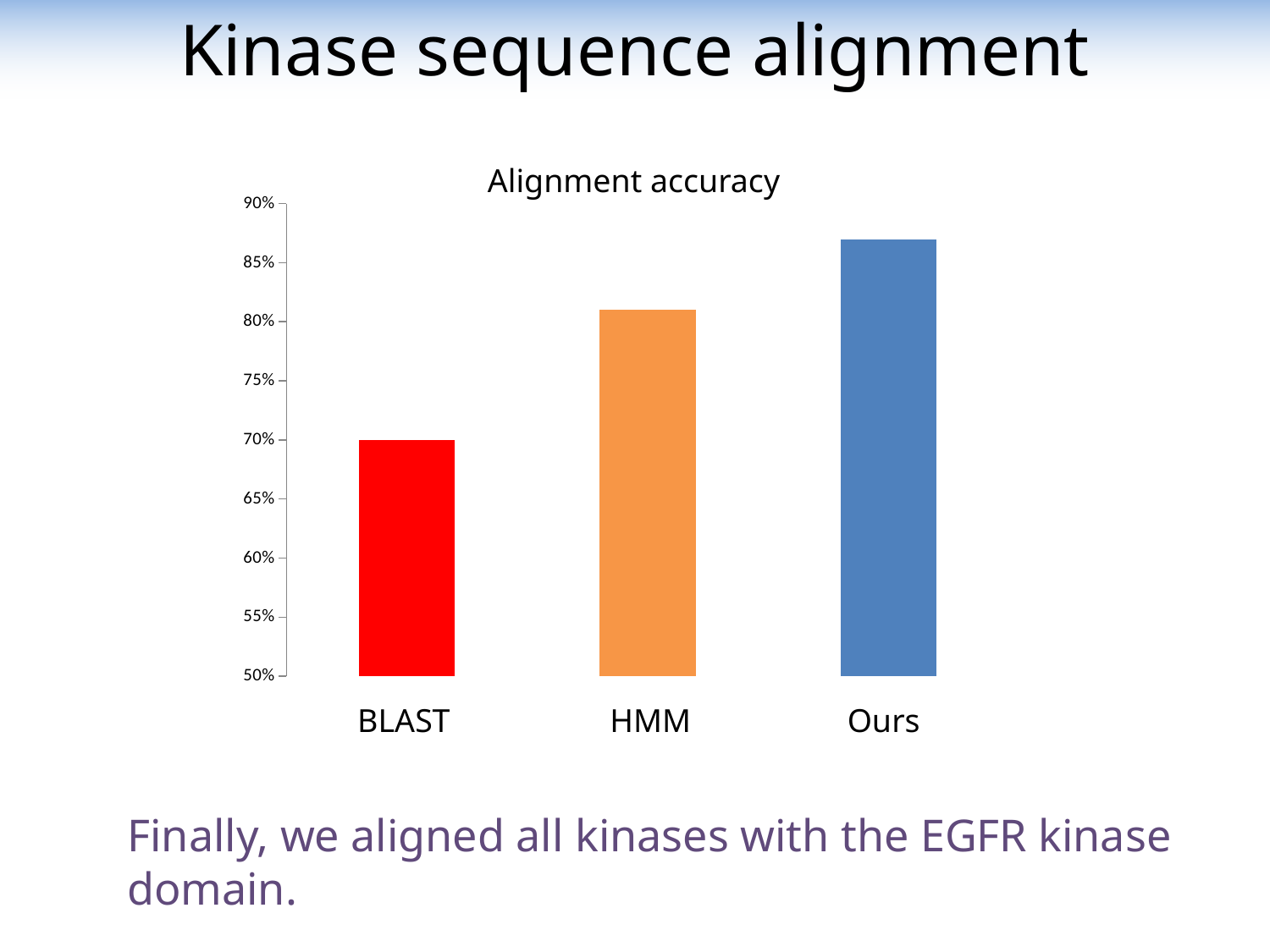
What colour is the bar for BLAST? red What kind of chart is shown on the slide? bar chart Is the value for Ours greater or less than 85%? greater Is the value for HMM greater or less than 85%? less Do the values rise or fall from left to right along the x axis? rise Which method has the highest alignment accuracy? Ours Is the value for HMM greater or less than 80%? greater Which has a higher alignment accuracy, HMM or Ours? Ours How many categories are shown on the x axis of the chart? 3 What is the alignment accuracy for BLAST? 70% Which method has the lowest alignment accuracy? BLAST What is the title of the chart? Alignment accuracy